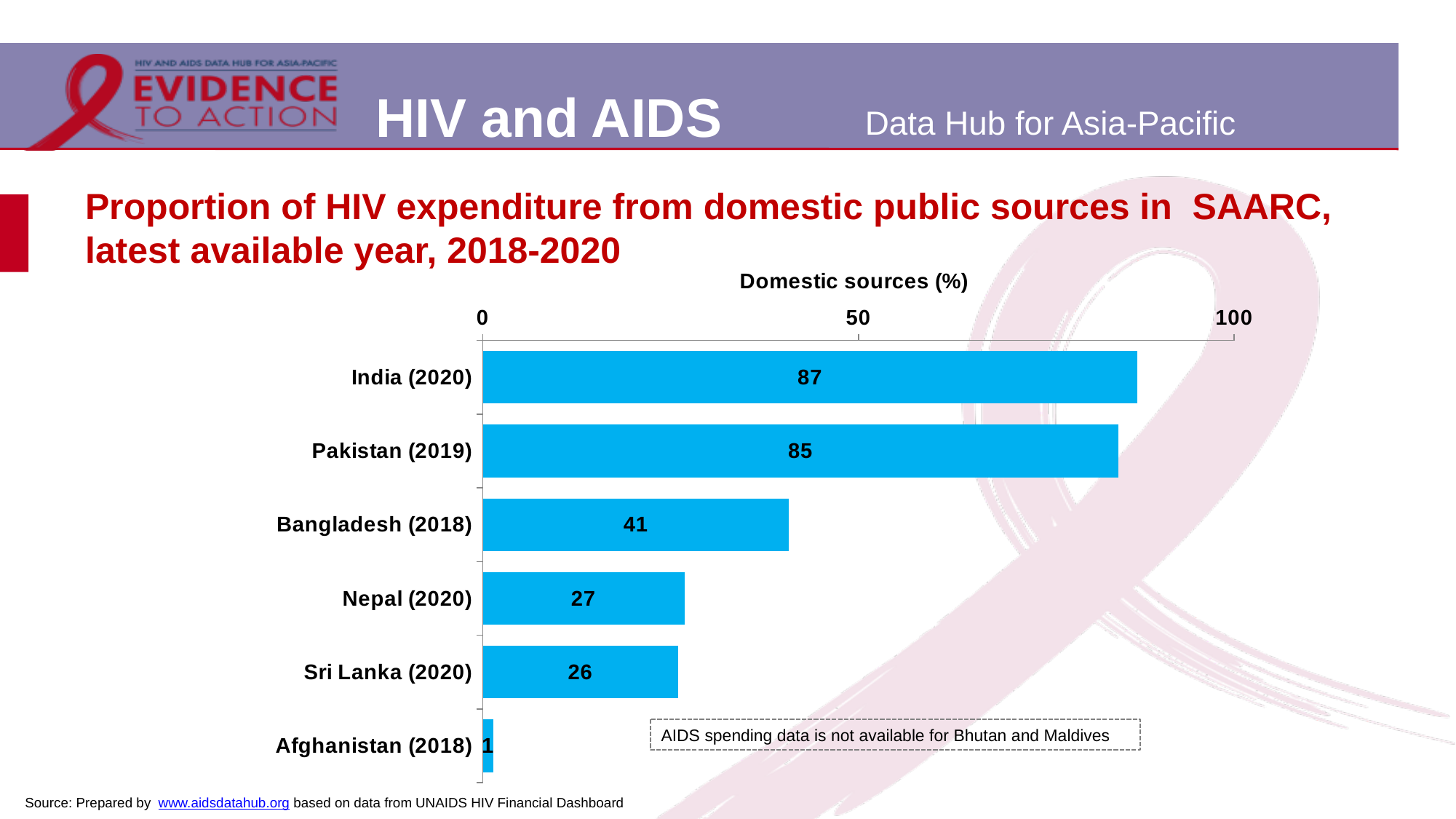
Which country has the lowest proportion of HIV expenditure from domestic public sources? Afghanistan (2018) What kind of chart is shown on the slide? bar chart Which country has the highest proportion of HIV expenditure from domestic public sources? India (2020) What is the value for Sri Lanka (2020)? 26 What is the label of the value axis of the chart? Domestic sources (%) What is the value for India (2020)? 87 What is the difference between the values for India (2020) and Pakistan (2019)? 2 What is the difference between the values for Bangladesh (2018) and Nepal (2020)? 14 Which is larger, the value for Nepal (2020) or Bangladesh (2018)? Bangladesh (2018) Is the value for Pakistan (2019) greater or less than 50? greater How many countries are shown in the chart? 6 What is the value for Bangladesh (2018)? 41